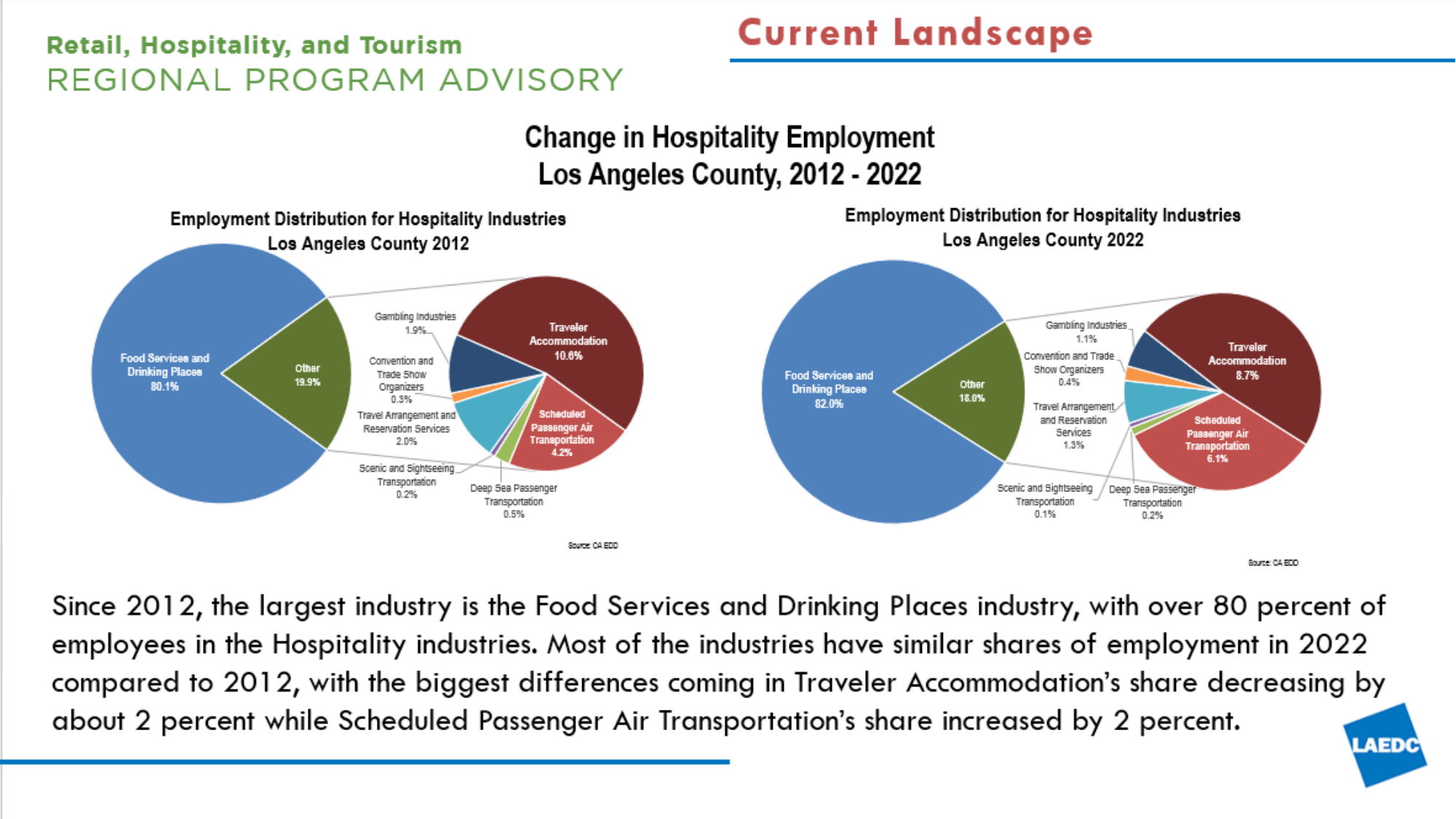
What kind of chart is used for the 2012 employment distribution? Pie chart In the 2012 chart, what is the share for Traveler Accommodation? 10.6% In the 2012 chart, which industry has the smallest share? Scenic and Sightseeing Transportation In the 2022 chart, what is the share for Scheduled Passenger Air Transportation? 6.1% In the 2022 chart, what is the share for Gambling Industries? 1.1% In the 2012 chart, what share of hospitality employment is Food Services and Drinking Places? 80.1% In the 2022 chart, which industry has the largest share? Food Services and Drinking Places What is the source cited below each chart? CA EDD In the 2022 chart, what share of hospitality employment is Food Services and Drinking Places? 82.0% In the 2022 chart, which is larger: the share for Traveler Accommodation or the share for Scheduled Passenger Air Transportation? Traveler Accommodation In the 2012 chart, what is the share for Travel Arrangement and Reservation Services? 2.0% What is the difference between the Traveler Accommodation share in 2012 and in 2022? 1.9%